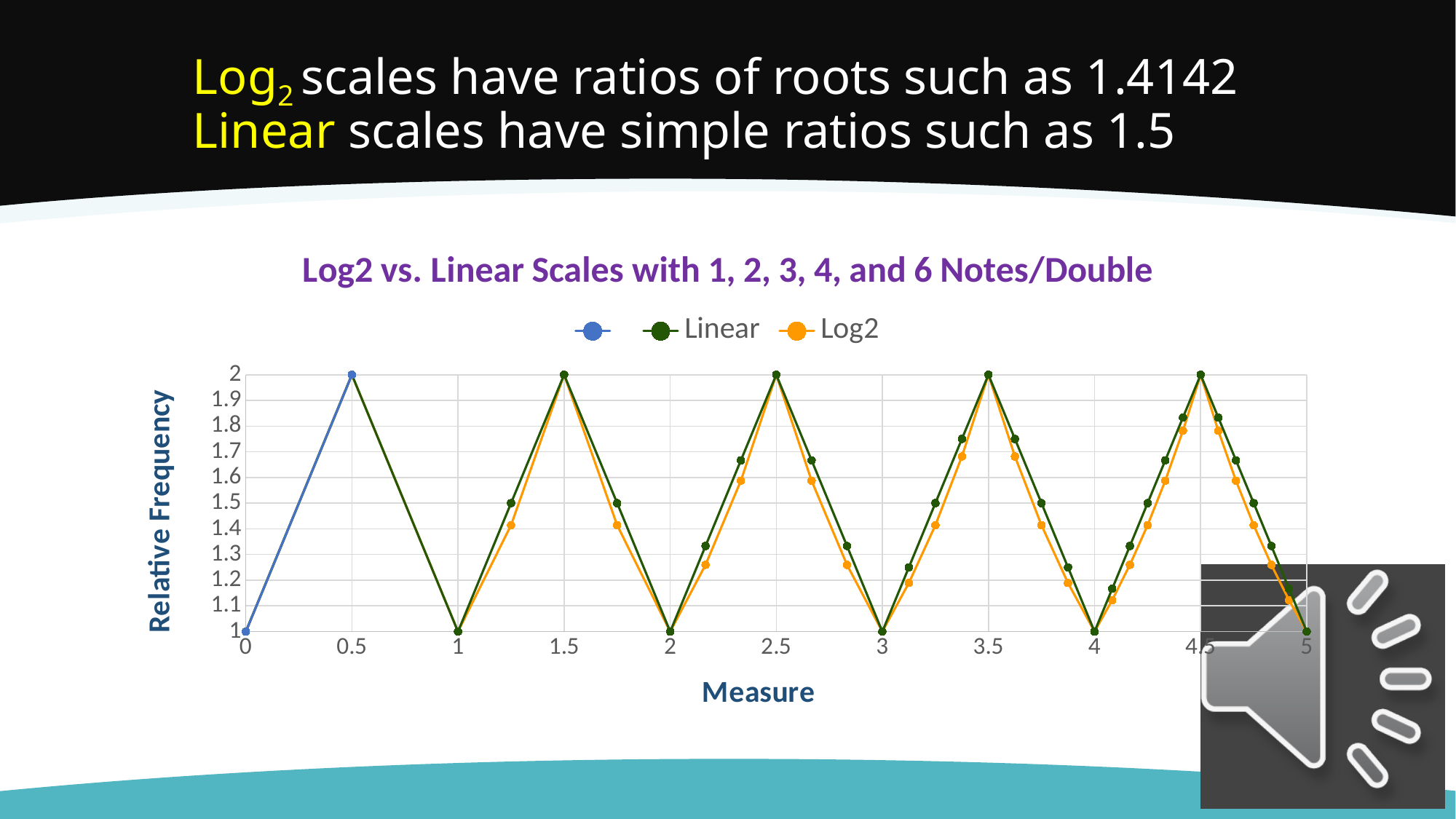
What is the highest Relative Frequency value reached by the Log2 series? 2 How many named series does the legend list? 2 Is the Log2 value at Measure 1.25 greater or less than 1.5? less What kind of chart is shown on the slide? line chart What is the title of the chart? Log2 vs. Linear Scales with 1, 2, 3, 4, and 6 Notes/Double What is the Relative Frequency of the Linear series at Measure 1? 1 Is the Linear value at Measure 3.25 greater or less than 1.2? greater What is the Relative Frequency of the Linear series at Measure 1.5? 2 What is the label of the x axis? Measure Between Measure 0 and Measure 0.5, does the plotted line rise or fall? rise What is the Relative Frequency of the Linear series at Measure 1.25? 1.5 At Measure 1.25, which series has the larger value, Linear or Log2? Linear